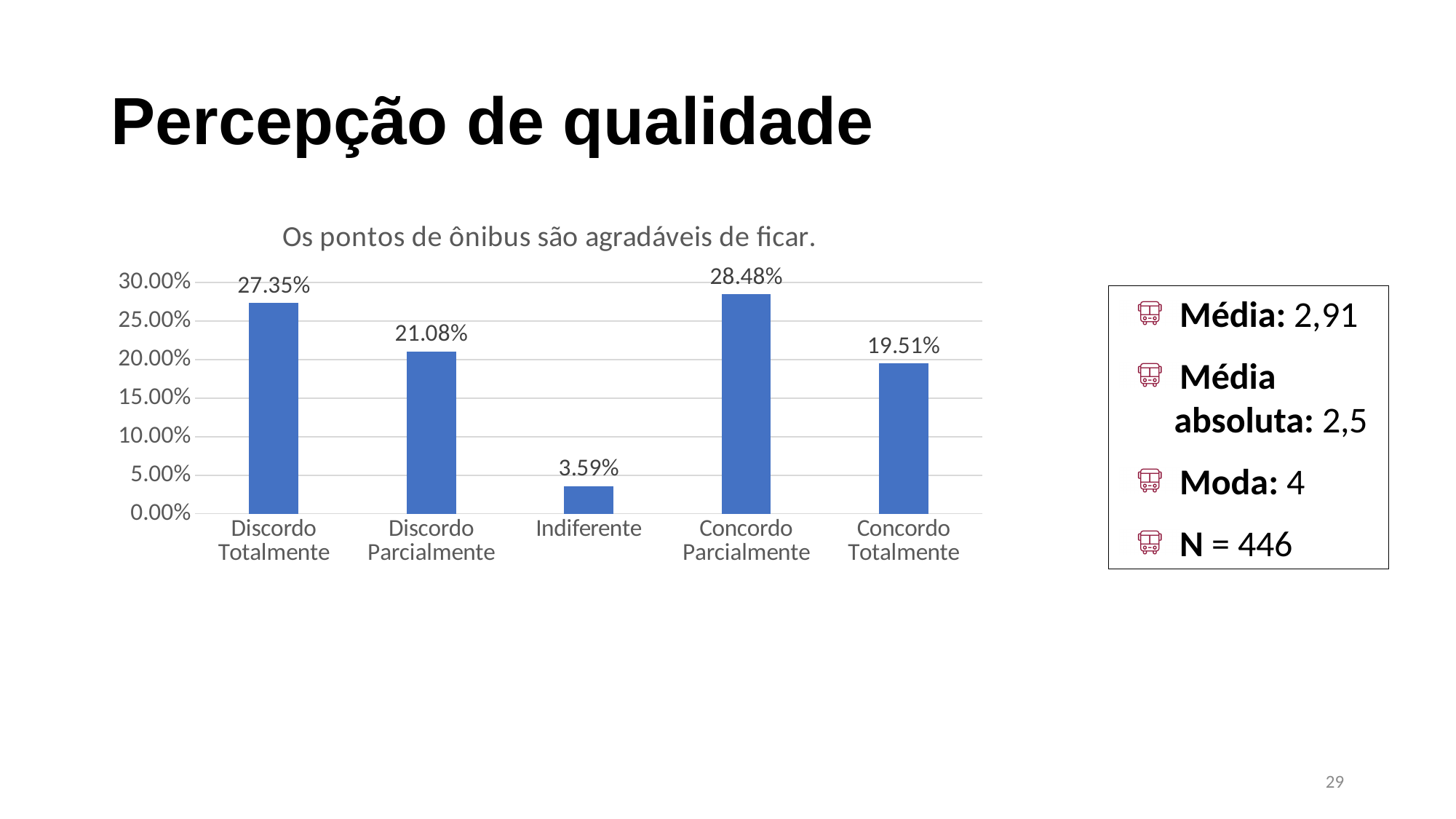
What is the value for Discordo Totalmente? 27.35% What is the value for Concordo Parcialmente? 28.48% What is the difference between Concordo Parcialmente and Concordo Totalmente? 8.97% Which category has the highest value? Concordo Parcialmente Which category has the lowest value? Indiferente What is the value for Concordo Totalmente? 19.51% What is the value for Discordo Parcialmente? 21.08% Which is larger, Discordo Totalmente or Discordo Parcialmente? Discordo Totalmente What is the title of the chart? Os pontos de ônibus são agradáveis de ficar. How many categories are shown on the x axis? 5 What kind of chart is shown? Bar chart What is the value for Indiferente? 3.59%